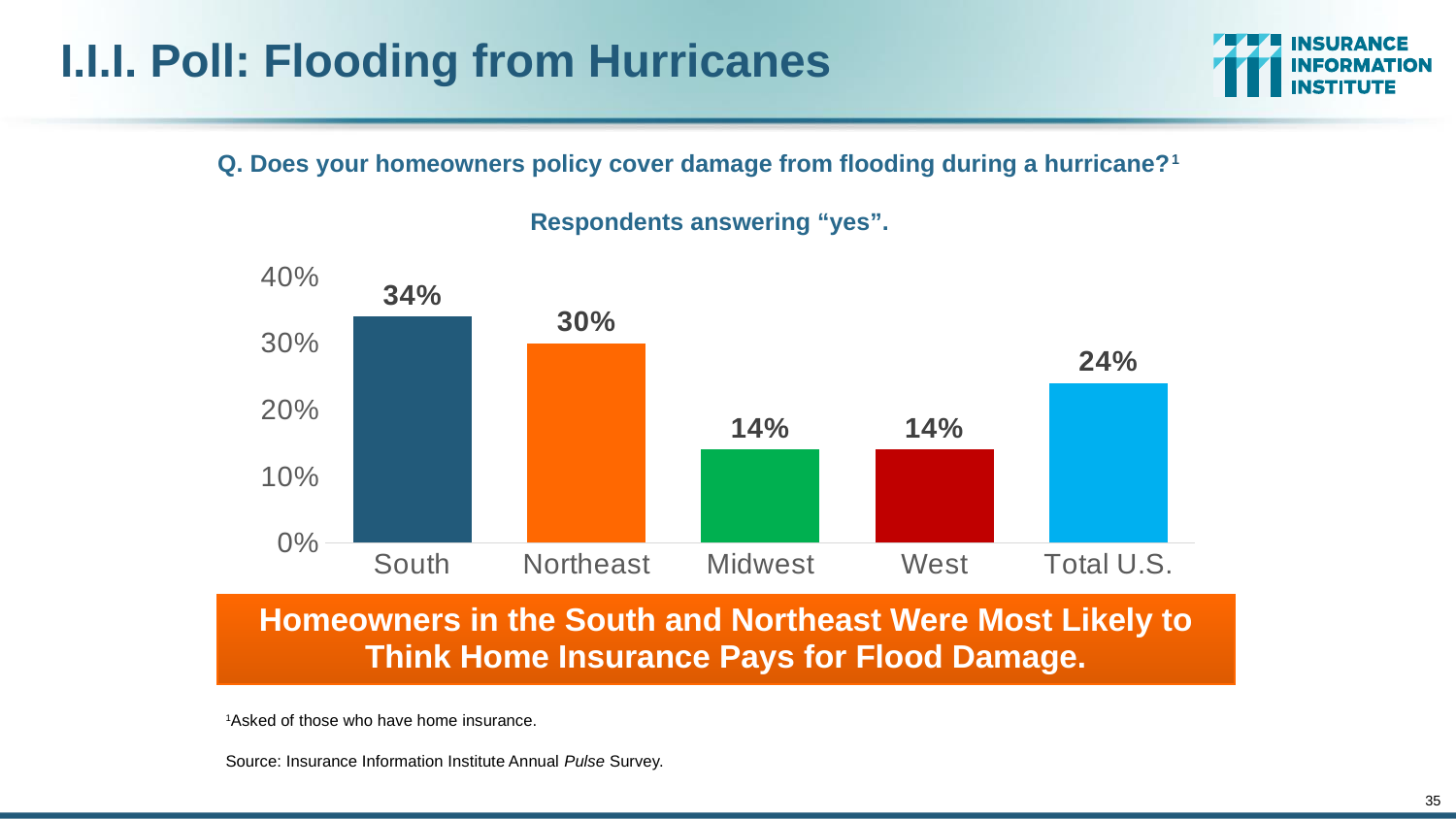
Which is larger, the value for the Northeast or the value for the Midwest? Northeast Is the value for Total U.S. greater or less than 20%? greater What is the subtitle printed above the chart? Respondents answering "yes". What percentage of respondents in the South answered "yes"? 34% What is the value shown for Total U.S.? 24% Which region has the highest percentage of respondents answering "yes"? South What kind of chart is shown on the slide? Bar chart What is the value shown for the West? 14% How many categories are shown on the x axis of the chart? 5 What is the difference between the South and the Northeast values? 4% What percentage is shown for the Northeast? 30% What is the difference between the Northeast and Total U.S. values? 6%